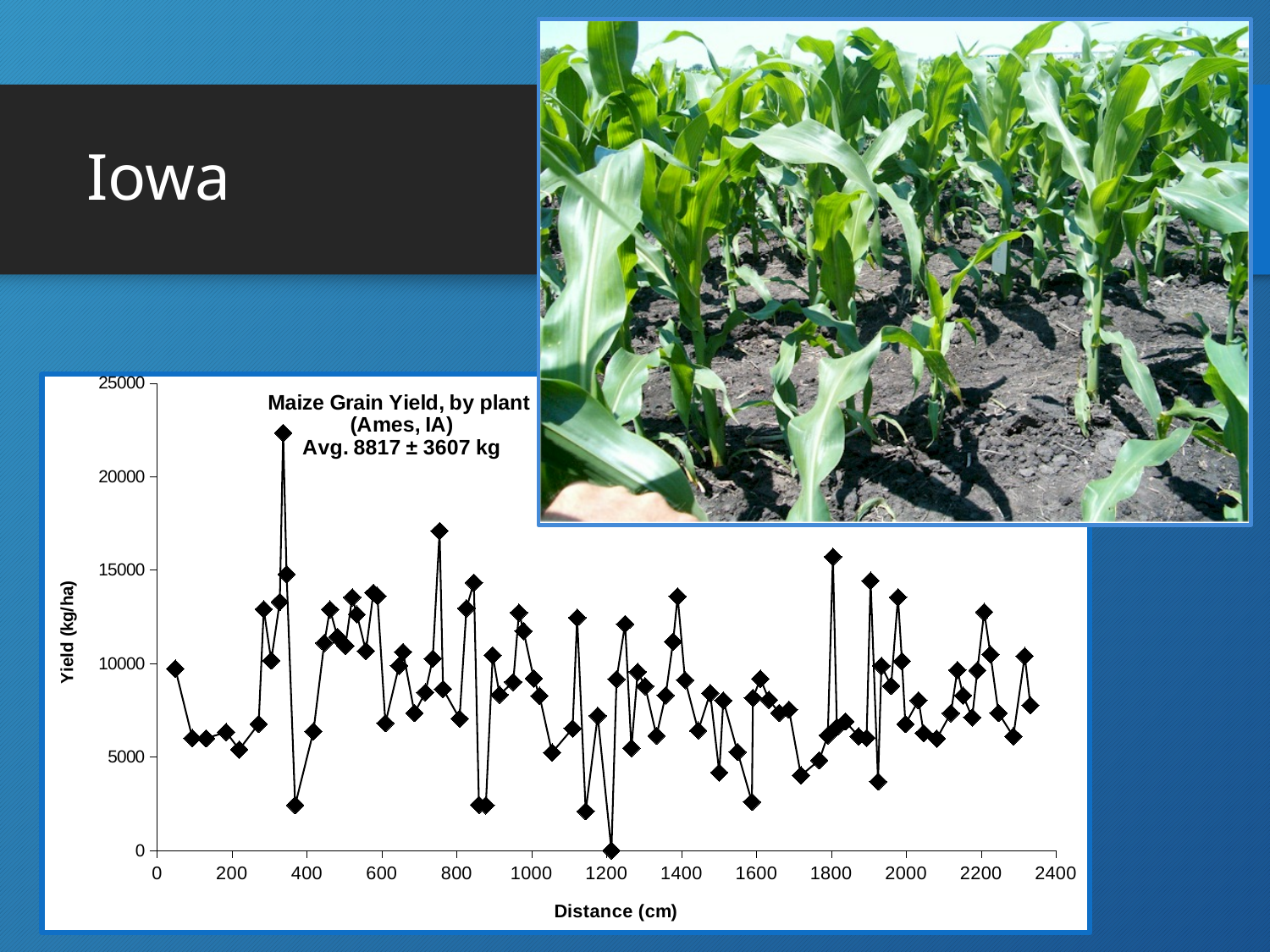
What is the label of the y axis of the chart? Yield (kg/ha) Is the yield at the first plotted point (near 50 cm) greater or less than 5000? greater Is the yield at the first plotted point (near 50 cm) greater or less than 15000? less Do the yield values show a steady rise, a steady fall, or fluctuate along the distance axis? fluctuate What is the lowest yield value plotted on the chart? 0 What is the title of the chart? Maize Grain Yield, by plant (Ames, IA) Avg. 8817 ± 3607 kg What kind of chart is shown on the slide? line chart What average yield is printed on the chart? 8817 ± 3607 kg Is the highest plotted yield value greater or less than 20000? greater Is the highest plotted yield value located before or after 1200 cm on the x axis? before